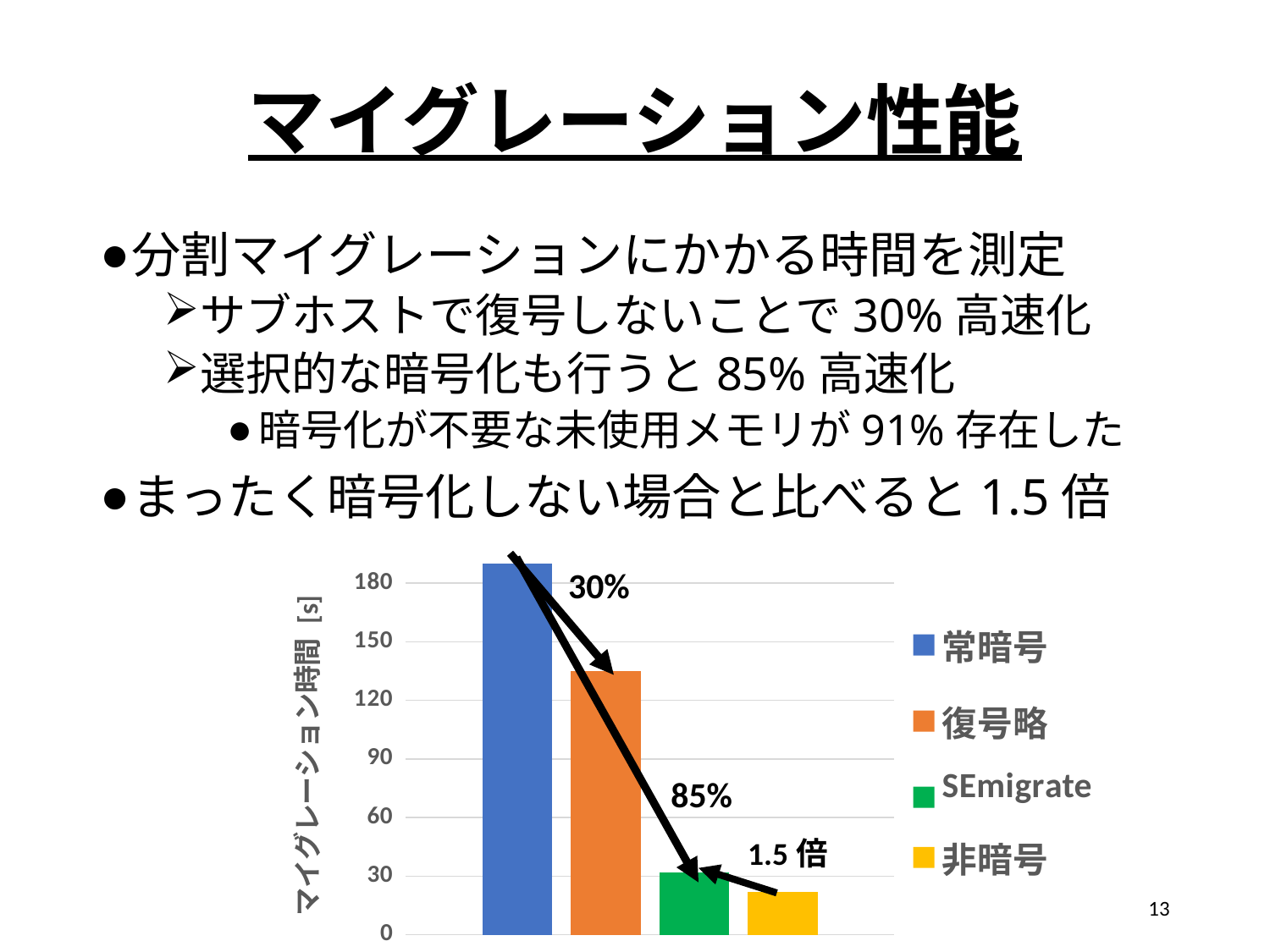
Which has a larger migration time, 常暗号 or 復号略? 常暗号 Is the value for 非暗号 greater or less than 30? less What kind of chart is shown on the slide? bar chart Is the value for SEmigrate greater or less than 60? less How many series does the chart legend list? 4 Is the value for 復号略 greater or less than 120? greater Which series has the lowest migration time in the chart? 非暗号 Which has a larger migration time, SEmigrate or 非暗号? SEmigrate Which series has the highest migration time in the chart? 常暗号 What is the label on the vertical axis of the chart? マイグレーション時間 [s] What colour is the bar for SEmigrate in the chart? green